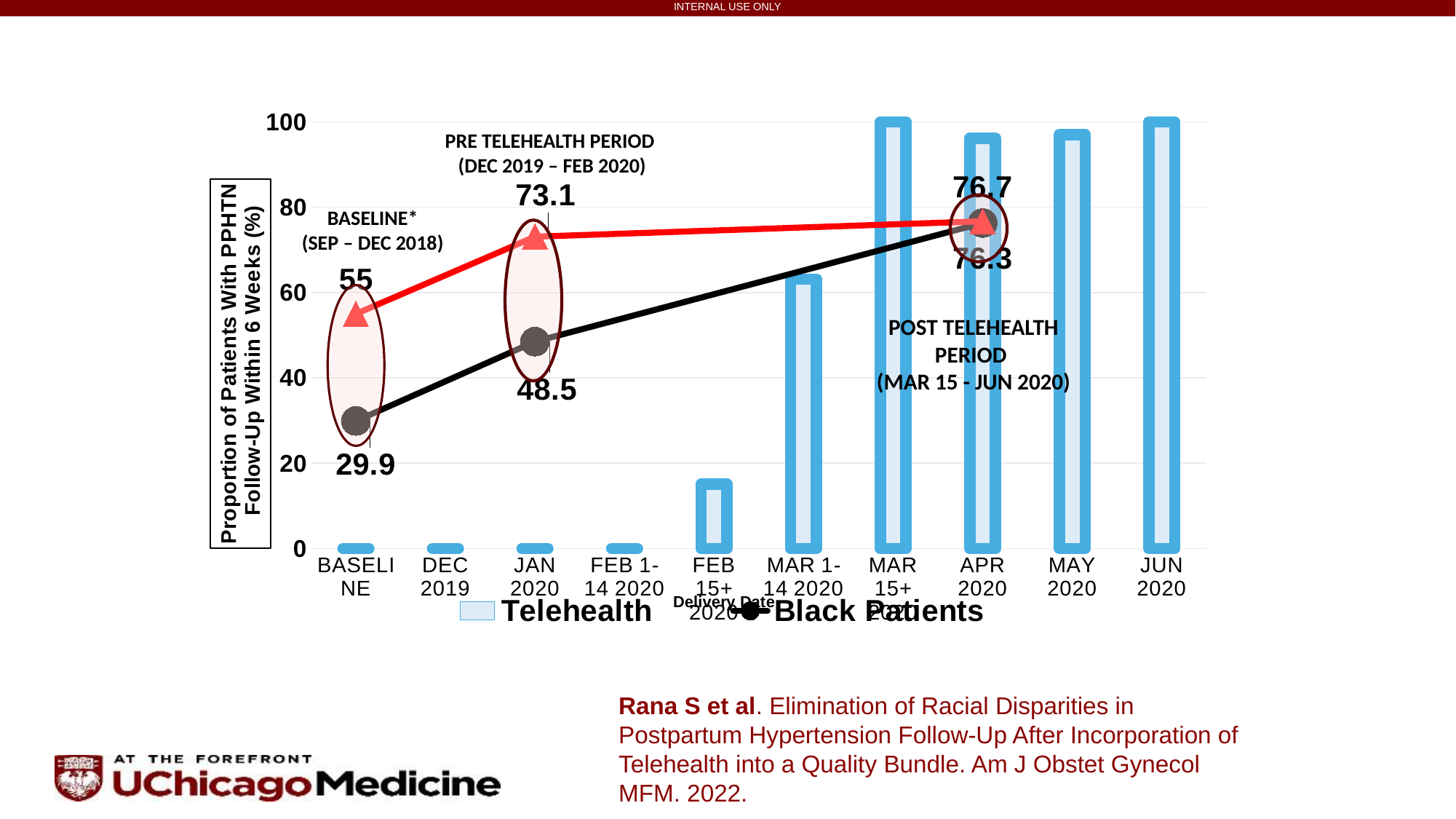
Is the Telehealth value for JUN 2020 greater or less than 80? greater How many delivery date categories are shown on the x axis? 10 What is the value for Black Patients at JAN 2020? 48.5 By how much did the Black Patients value increase from BASELINE to JAN 2020? 18.6 What is the value for Black Patients at BASELINE? 29.9 Is the Telehealth value for FEB 15+ 2020 greater or less than 20? less Which is larger for Black Patients: the value at BASELINE or the value at JAN 2020? JAN 2020 Is the Telehealth value for MAR 1-14 2020 greater or less than 40? greater What kind of chart is this? combined bar and line chart Does the Black Patients line rise or fall from BASELINE to APR 2020? rises What is the title of the y axis? Proportion of Patients With PPHTN Follow-Up Within 6 Weeks (%)